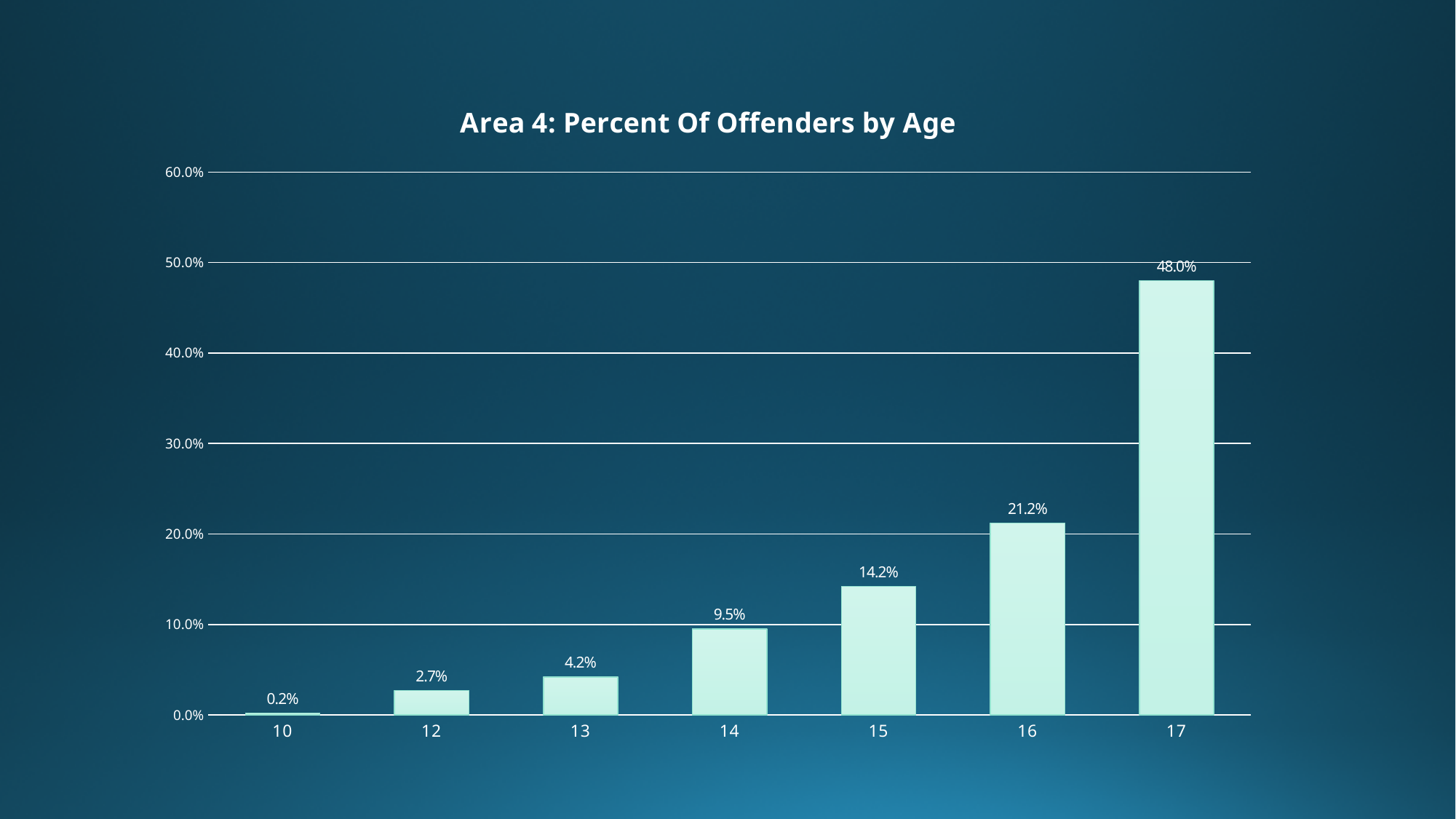
Which is larger, the percent of offenders for age 15 or age 14? 15 What kind of chart is shown on the slide? bar chart Which age has the highest percent of offenders? 17 What is the difference between the percent of offenders for age 15 and age 13? 10.0% Which age has the lowest percent of offenders? 10 What is the percent of offenders for age 17? 48.0% Do the values rise or fall as age increases along the x axis? rise What is the percent of offenders for age 12? 2.7% What is the difference between the percent of offenders for age 17 and age 16? 26.8% Is the value for age 16 greater or less than 20.0%? greater How many age categories are shown on the chart? 7 What is the percent of offenders for age 14? 9.5%